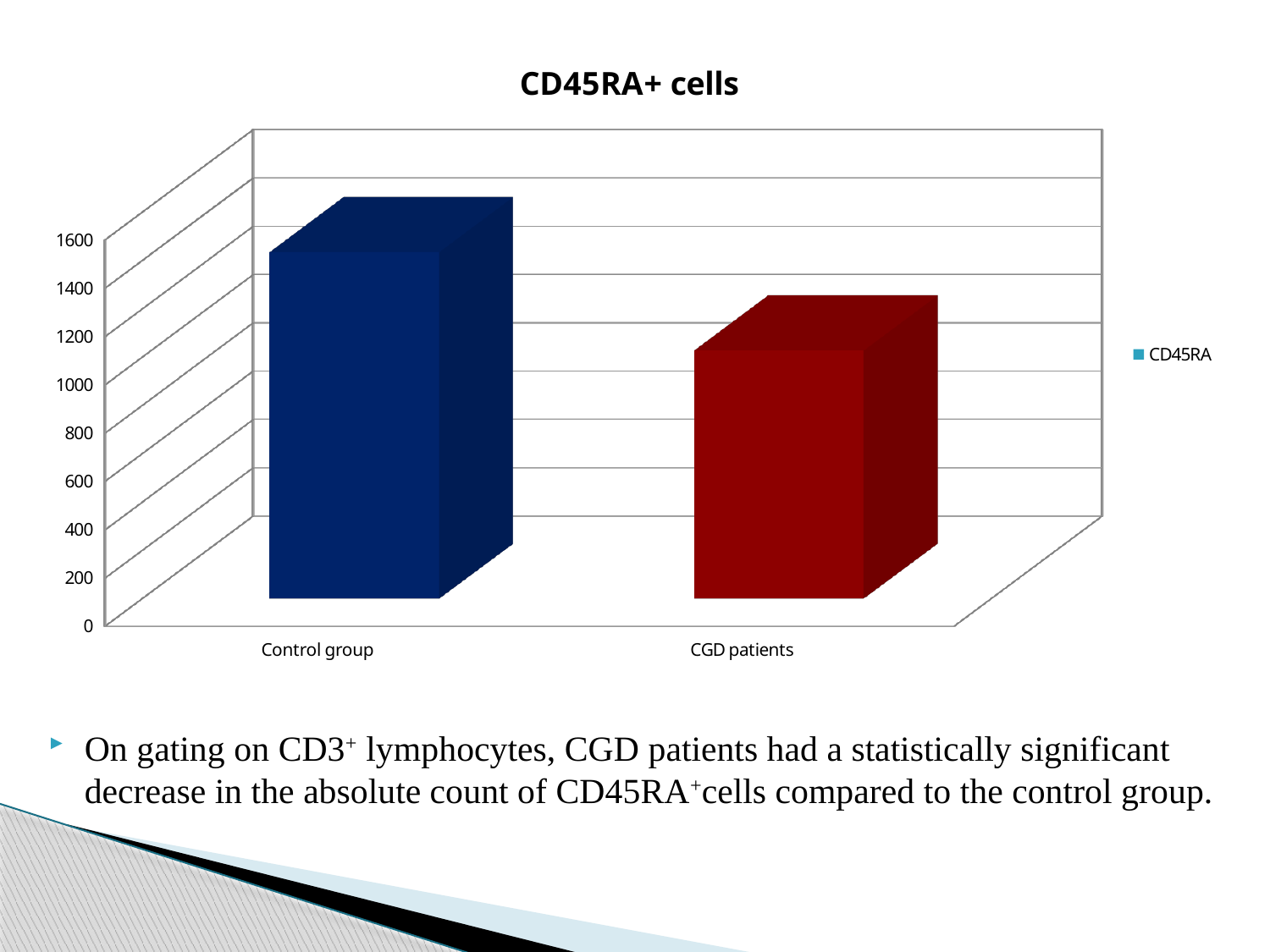
Do the values rise or fall from Control group to CGD patients? fall What is the title of the chart? CD45RA+ cells Is the value for Control group greater or less than 1200? greater How many categories are shown on the x axis of the chart? 2 Which is larger, the value for Control group or the value for CGD patients? Control group Which category has the highest bar? Control group What series name appears in the legend? CD45RA Is the value for CGD patients greater or less than 1400? less What kind of chart is shown on the slide? bar chart Which category has the lowest bar? CGD patients Is the value for CGD patients greater or less than 800? greater How many series does the legend list? 1